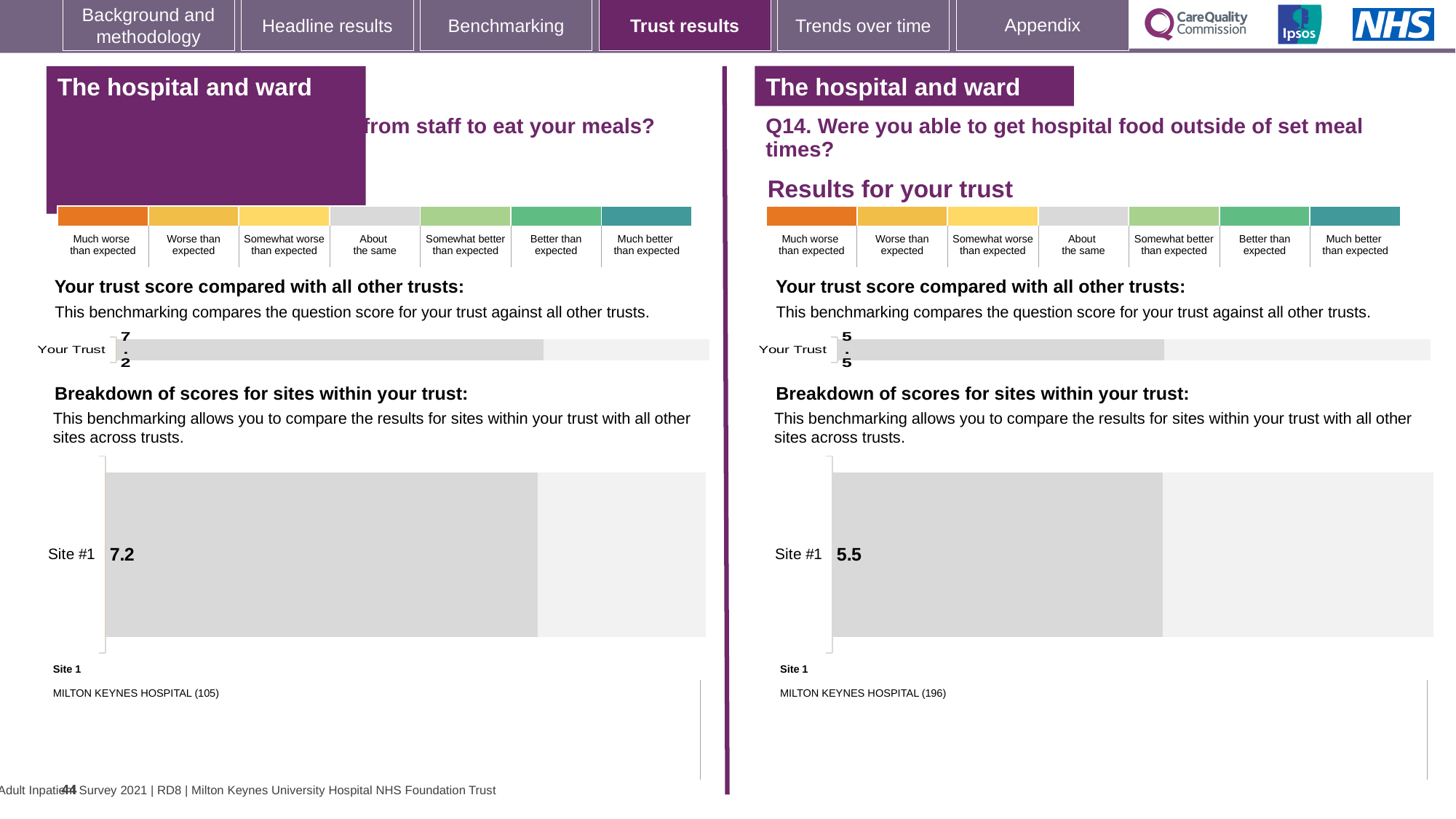
On the left-hand side, which hospital is listed as Site 1 below the site breakdown chart? MILTON KEYNES HOSPITAL (105) Which is larger: the Site #1 score on the left-hand chart or the Site #1 score on the right-hand (Q14) chart? Left-hand chart (7.2) On the left-hand side, what is the score shown for Your Trust in the 'Your trust score compared with all other trusts' chart? 7.2 On the left-hand side, what score is shown for Site #1 in the 'Breakdown of scores for sites within your trust' chart? 7.2 On the right-hand side (Q14), what score is shown for Site #1 in the 'Breakdown of scores for sites within your trust' chart? 5.5 What type of chart is used to show the Site #1 score on the right-hand side (Q14)? Bar chart How many sites are shown in the 'Breakdown of scores for sites within your trust' chart on the left-hand side? 1 What type of chart is used to show the Your Trust score on the left-hand side? Bar chart On the right-hand side (Q14), what is the score shown for Your Trust in the 'Your trust score compared with all other trusts' chart? 5.5 What is the difference between the Site #1 score on the left-hand chart (7.2) and the Site #1 score on the right-hand Q14 chart (5.5)? 1.7 How many sites are shown in the 'Breakdown of scores for sites within your trust' chart on the right-hand side (Q14)? 1 On the right-hand side (Q14), which hospital is listed as Site 1 below the site breakdown chart? MILTON KEYNES HOSPITAL (196)